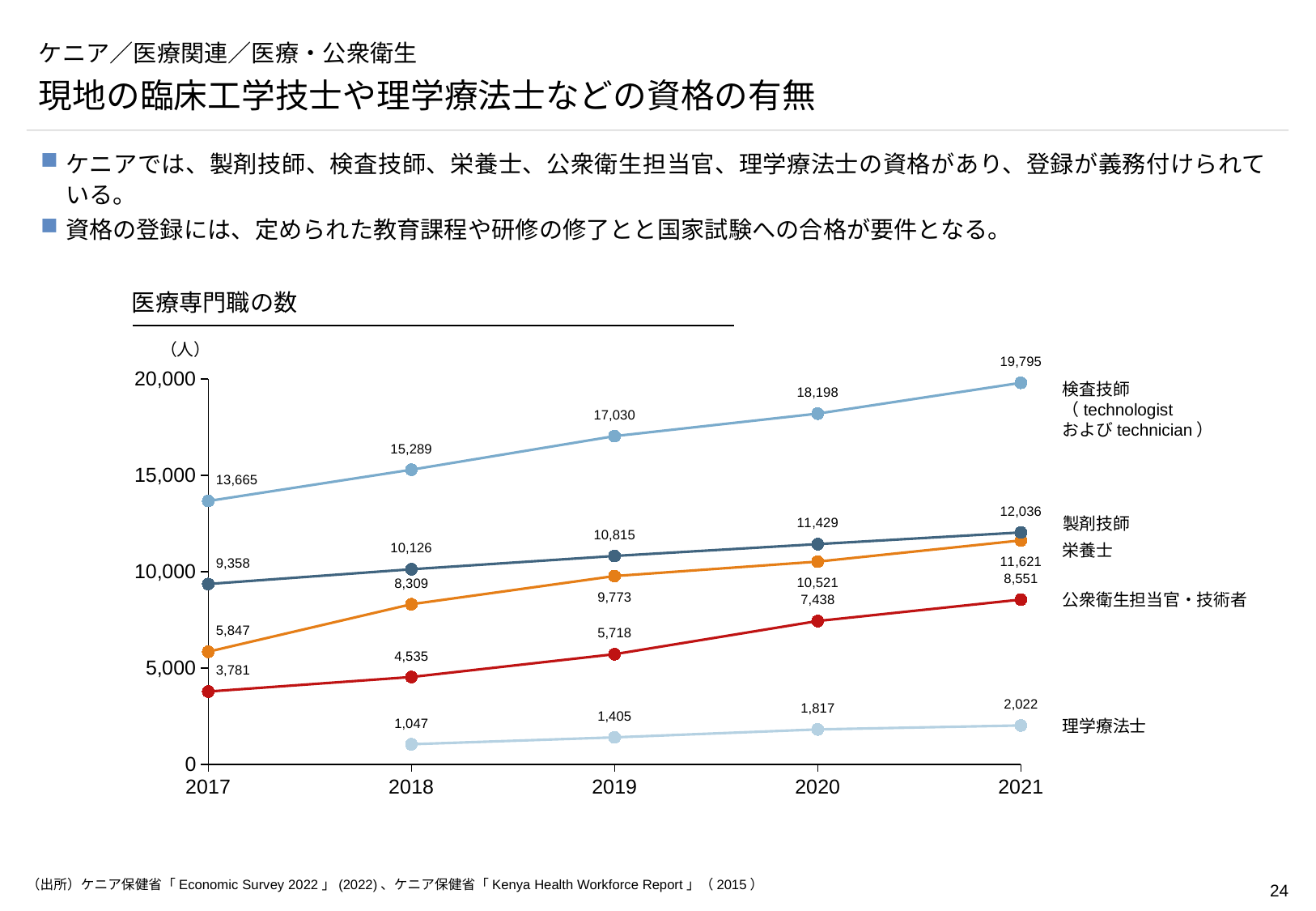
Does the number of 公衆衛生担当官・技術者 rise or fall from 2017 to 2021? rise How many professions (series) are plotted in the chart? 5 What was the number of 検査技師 in 2021? 19,795 By how much did the number of 検査技師 increase from 2017 to 2021? 6,130 What was the number of 製剤技師 in 2019? 10,815 In 2021, which was larger: the number of 製剤技師 or the number of 栄養士? 製剤技師 What was the number of 理学療法士 in 2018? 1,047 Which profession had the highest number in 2021? 検査技師 What was the number of 栄養士 in 2017? 5,847 What kind of chart is shown on the slide? line chart What was the number of 公衆衛生担当官・技術者 in 2020? 7,438 Which profession had the lowest number in 2020? 理学療法士